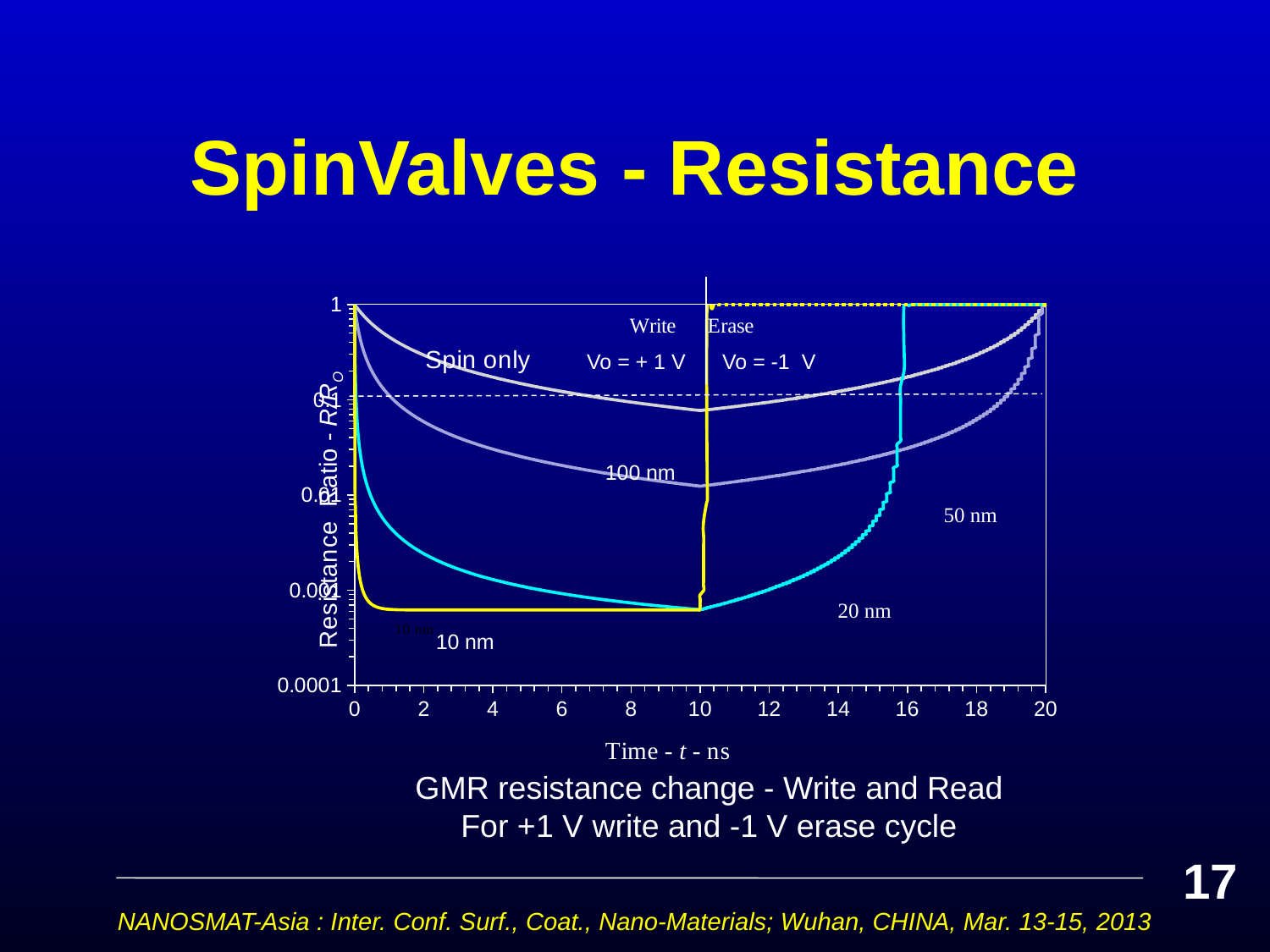
Do the curves rise or fall between 0 and 10 ns during the write phase? fall At 10 ns, which curve has the larger resistance ratio, 100 nm or 20 nm? 100 nm What kind of chart is shown on the slide? line chart What resistance ratio value do all the curves start from at time 0? 1 What is the label of the x axis? Time - t - ns Is the value of the 10 nm curve at 10 ns greater or less than 0.01? less Which curve stays highest throughout the write phase? Spin only What is the maximum value shown on the x axis? 20 Which curve drops to the lowest resistance ratio during the write phase? 10 nm At what time on the x axis does the erase phase (Vo = -1 V) begin? 10